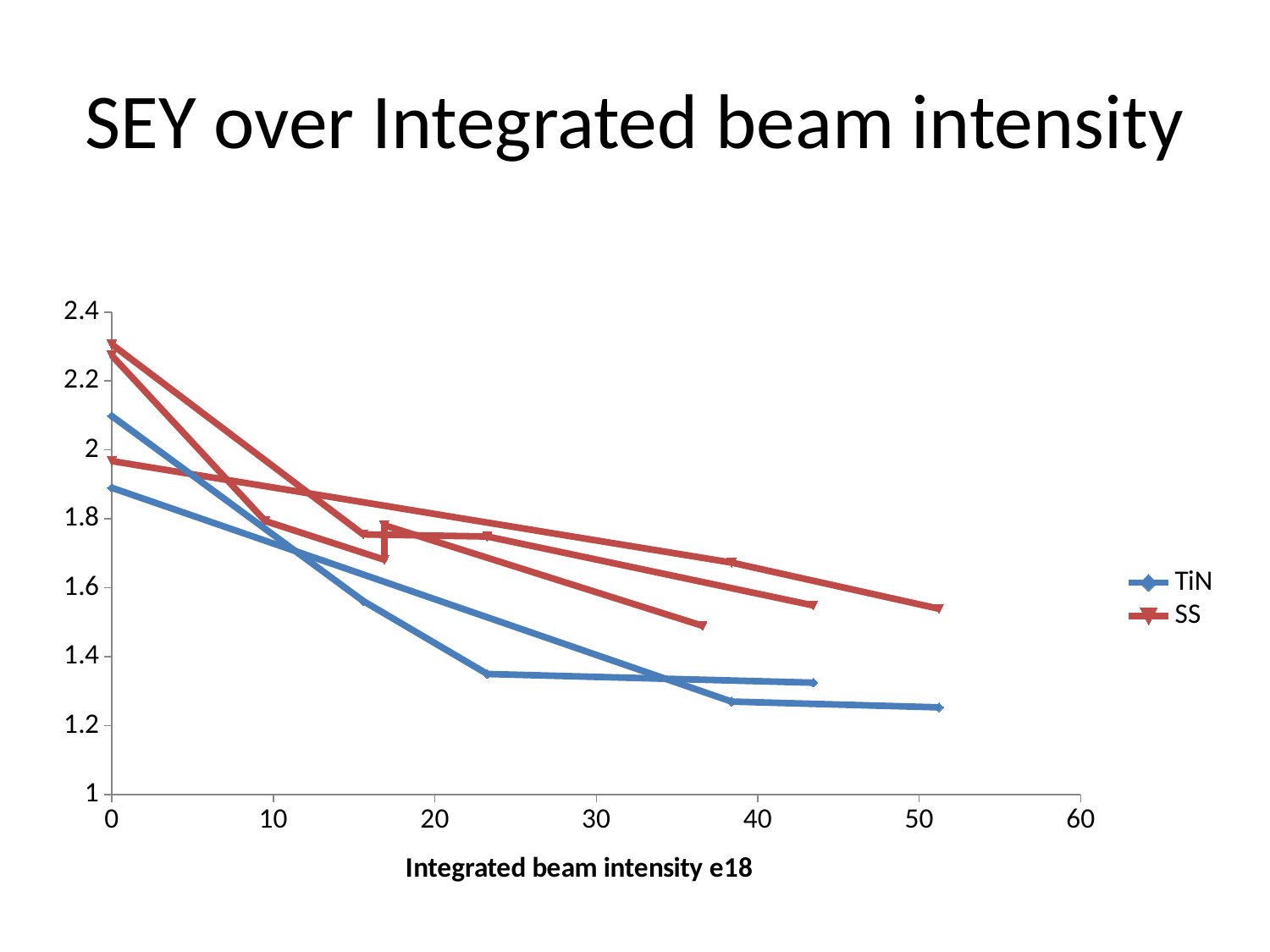
Do the SEY values rise or fall as integrated beam intensity increases along the x axis? fall Is the SS value at the far right end of its lines (around 50 on the x axis) greater or less than 1.4? greater What is the title of the chart on the slide? SEY over Integrated beam intensity Are the starting SS values at x = 0 greater or less than 1.8? greater What kind of chart is shown on the slide? line chart Do the TiN values rise or fall along the x axis? fall Which series reaches the lowest SEY value on the chart? TiN What are the two series named in the legend? TiN and SS How many series does the legend list? 2 At the right end of the chart (around 50 on the x axis), which series has the higher SEY value, TiN or SS? SS Is the TiN value at the far right end of its lines (around 50 on the x axis) greater or less than 1.4? less